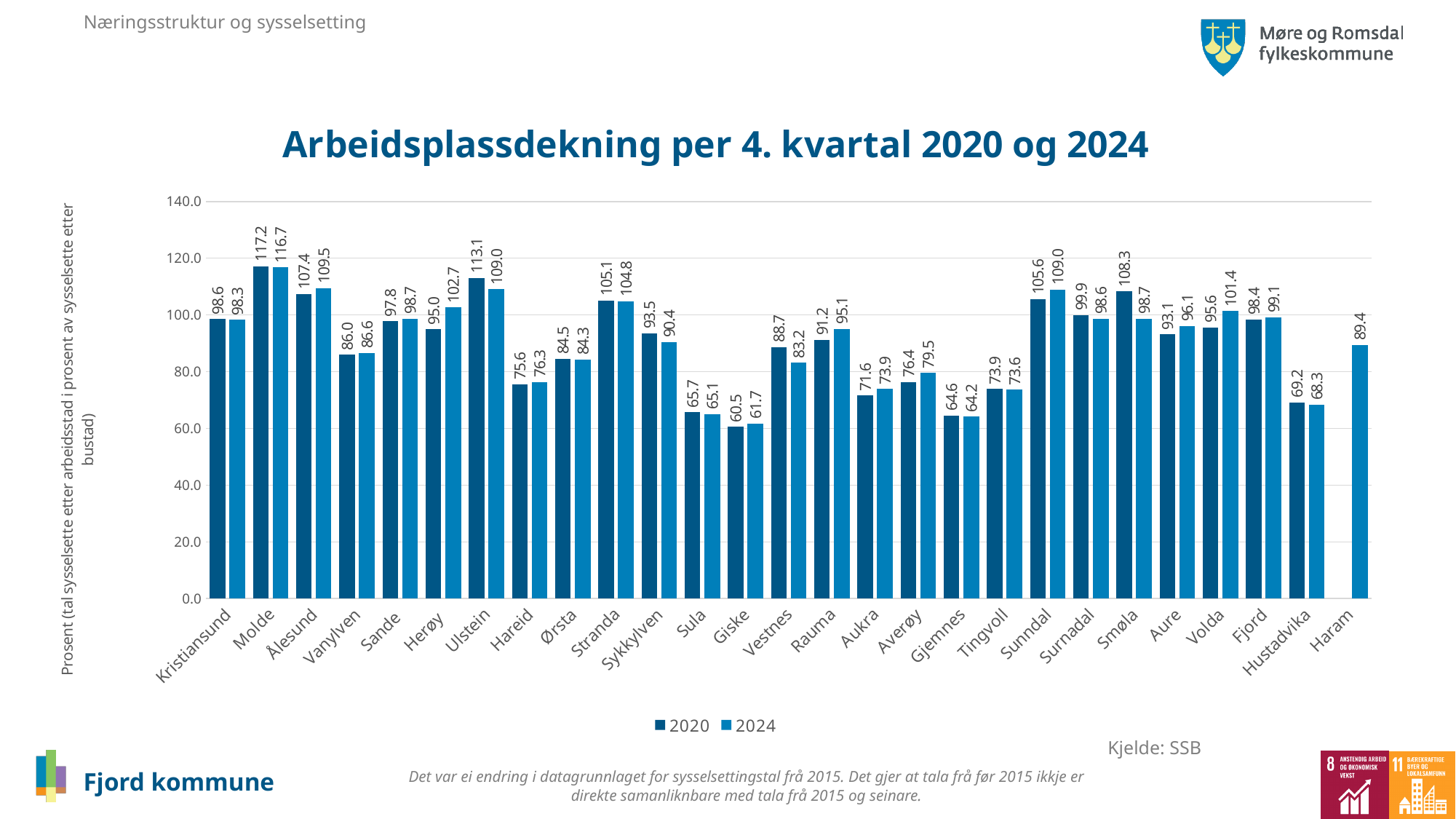
How many municipalities are shown on the x axis? 27 What is the difference between the 2024 and 2020 values for Herøy? 7.7 Is the 2024 value for Sunndal greater or less than 100.0? greater What kind of chart is shown on the slide? Bar chart What is the value for Fjord in 2024? 99.1 How many series does the legend list? 2 What is the difference between the 2020 and 2024 values for Smøla? 9.6 What is the value for Molde in 2020? 117.2 Which is larger for Ulstein: the 2020 value or the 2024 value? 2020 Which municipality has the highest value in 2020? Molde Which municipality has the lowest value in 2024? Giske What is the value for Haram in 2024? 89.4